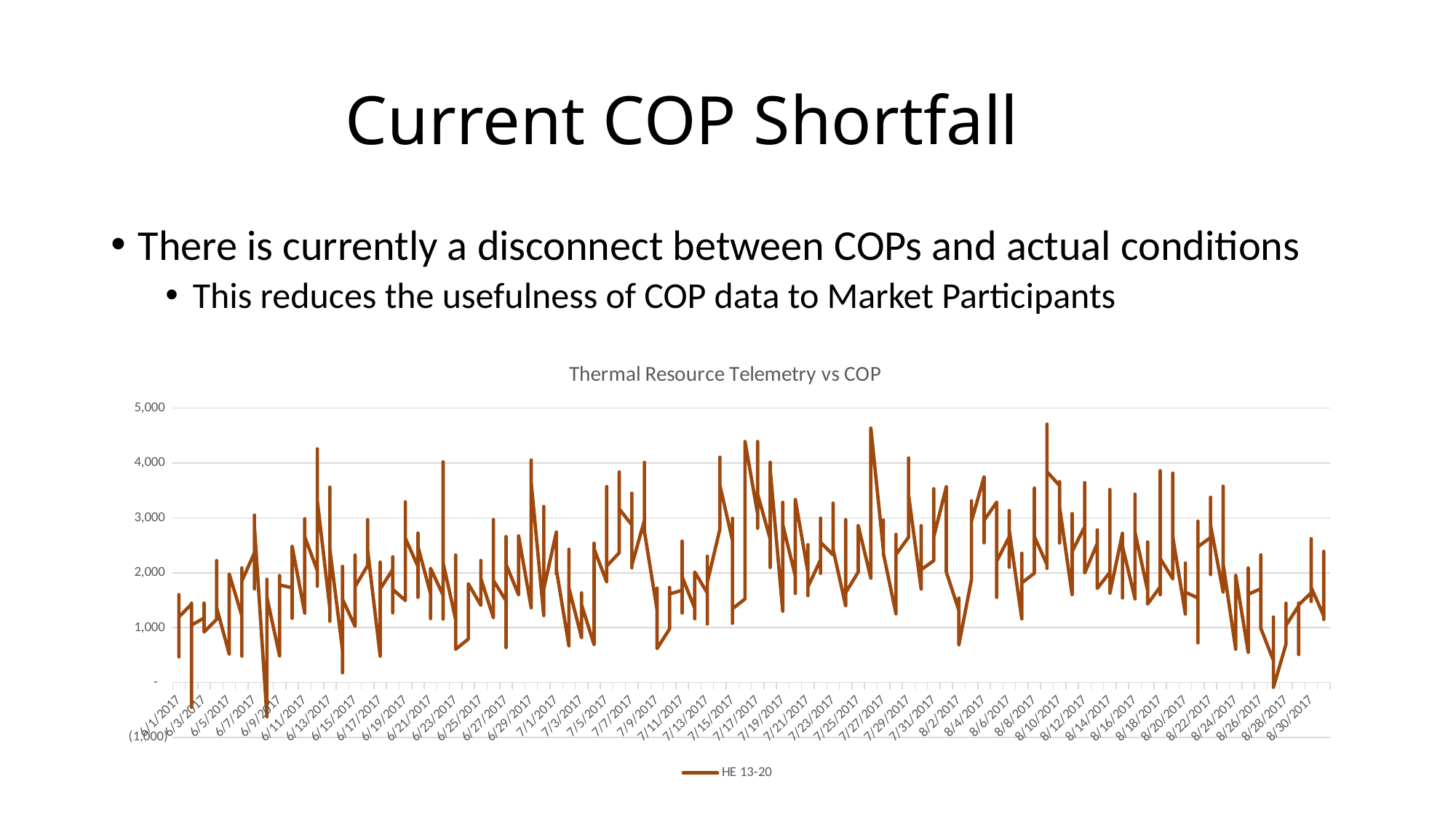
Is the highest value of the HE 13-20 series greater or less than 5,000? less What is the title of the chart? Thermal Resource Telemetry vs COP Is the value for the first point (6/1/2017) greater or less than 2,000? less Is the lowest value of the HE 13-20 series greater or less than 1,000? less How many series does the chart's legend list? 1 What kind of chart is shown on the slide? line chart What is the name of the series shown in the legend? HE 13-20 What is the highest value shown on the vertical axis? 5,000